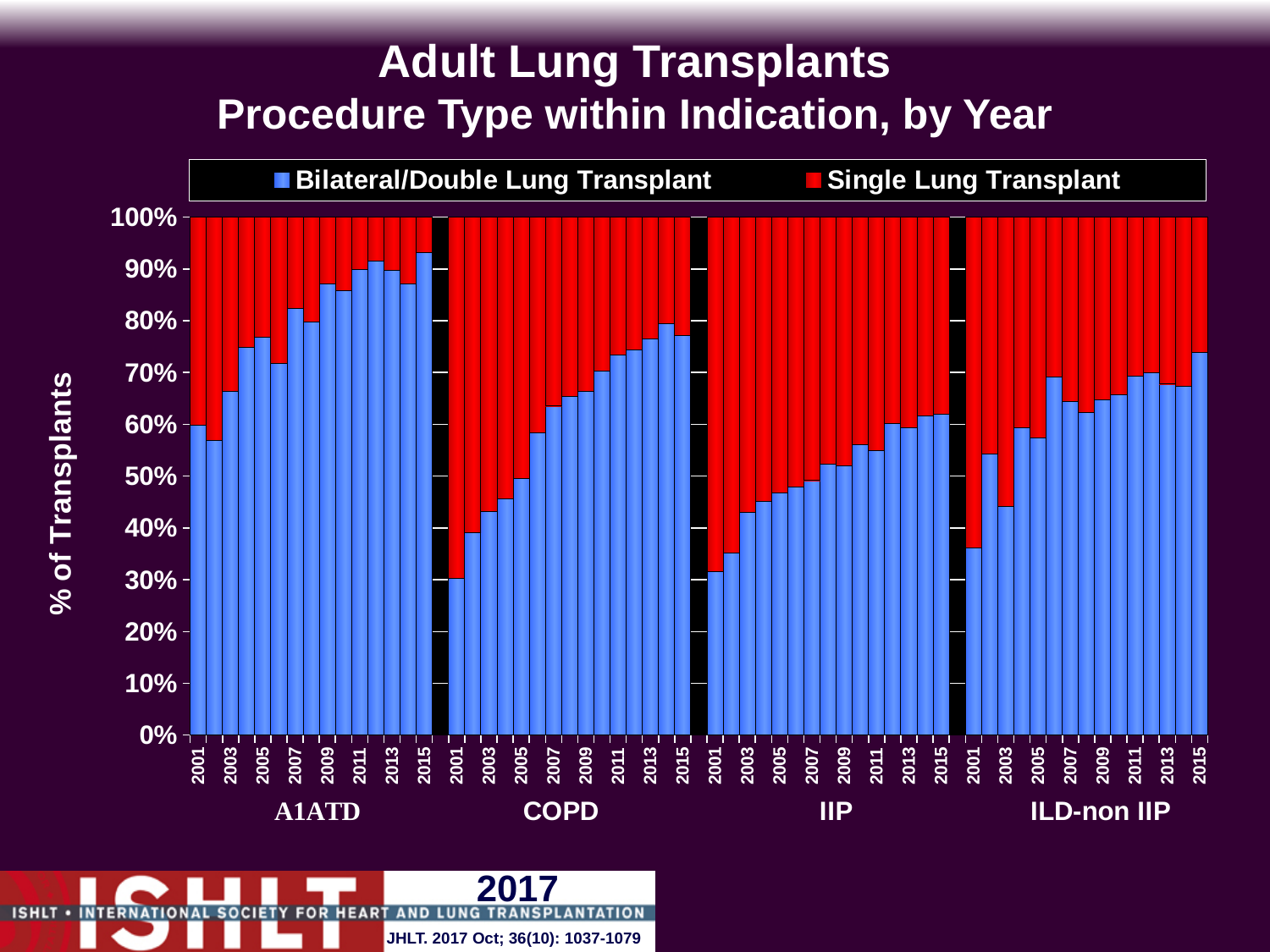
Does the Bilateral/Double Lung Transplant share for COPD rise or fall from 2001 to 2015? rise Which indication has the larger Bilateral/Double Lung Transplant share in 2001, A1ATD or COPD? A1ATD Is the Bilateral/Double Lung Transplant share for A1ATD in 2015 greater or less than 90%? greater Which colour represents Single Lung Transplant in the chart? Red How many series does the legend list? 2 How many years are plotted for each indication group? 15 Is the Bilateral/Double Lung Transplant share for ILD-non IIP in 2015 greater or less than 70%? greater How many indication groups are shown along the x axis? 4 Is the Bilateral/Double Lung Transplant share for IIP in 2001 greater or less than 40%? less Which indication group has the highest Bilateral/Double Lung Transplant share in 2015? A1ATD What kind of chart is shown on the slide? Stacked bar chart